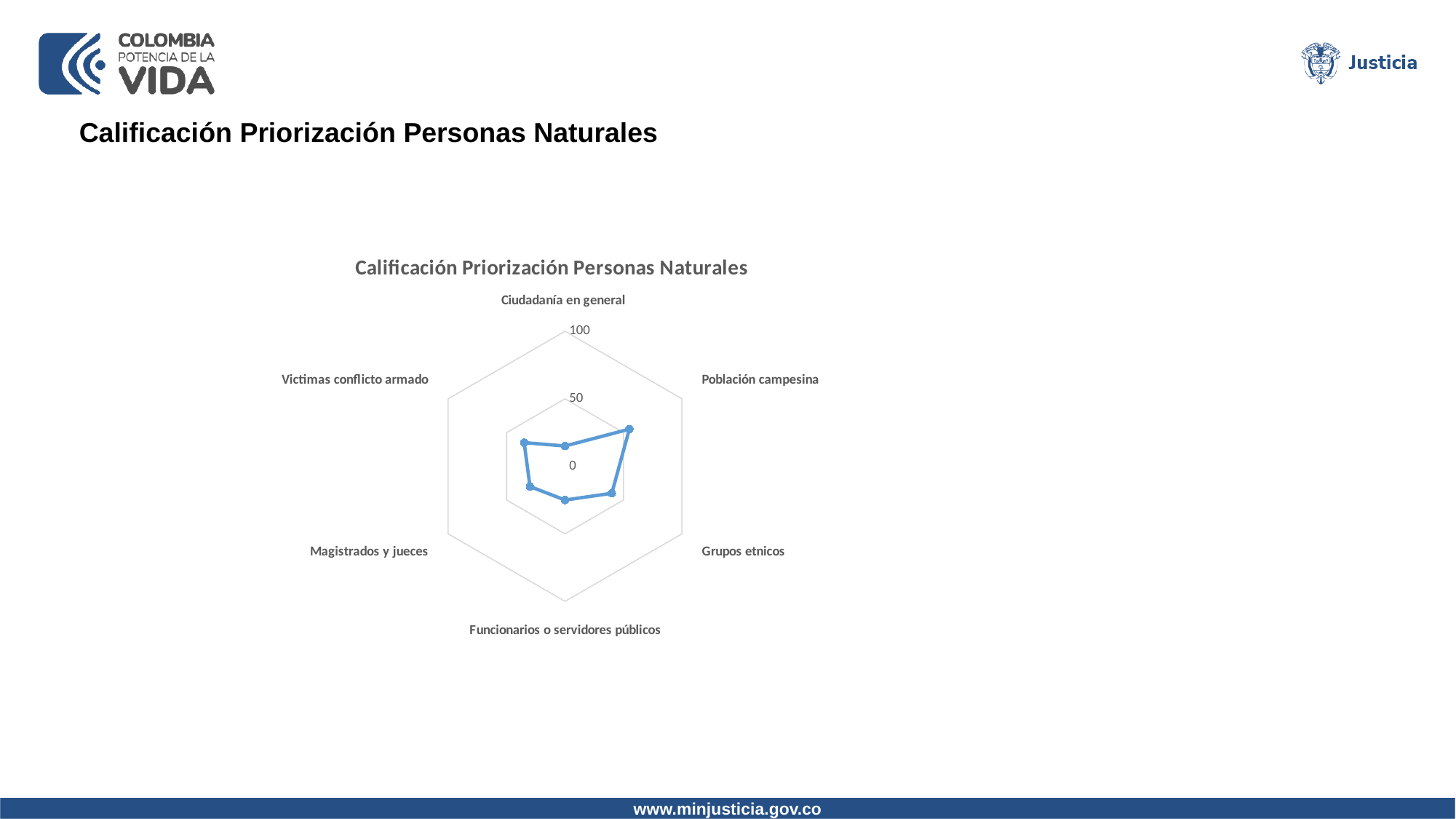
Which category has the lowest value on the chart? Ciudadanía en general What kind of chart is shown on the slide? Radar chart Is the value for Magistrados y jueces greater or less than 50? less Which category has the highest value on the chart? Población campesina What is the title of the chart? Calificación Priorización Personas Naturales Which is larger, the value for Población campesina or the value for Ciudadanía en general? Población campesina Is the value for Victimas conflicto armado greater or less than 100? less How many categories are plotted on the radar chart? 6 Is the value for Funcionarios o servidores públicos greater or less than 50? less What is the maximum value shown on the chart's axis scale? 100 Which is larger, the value for Grupos etnicos or the value for Ciudadanía en general? Grupos etnicos